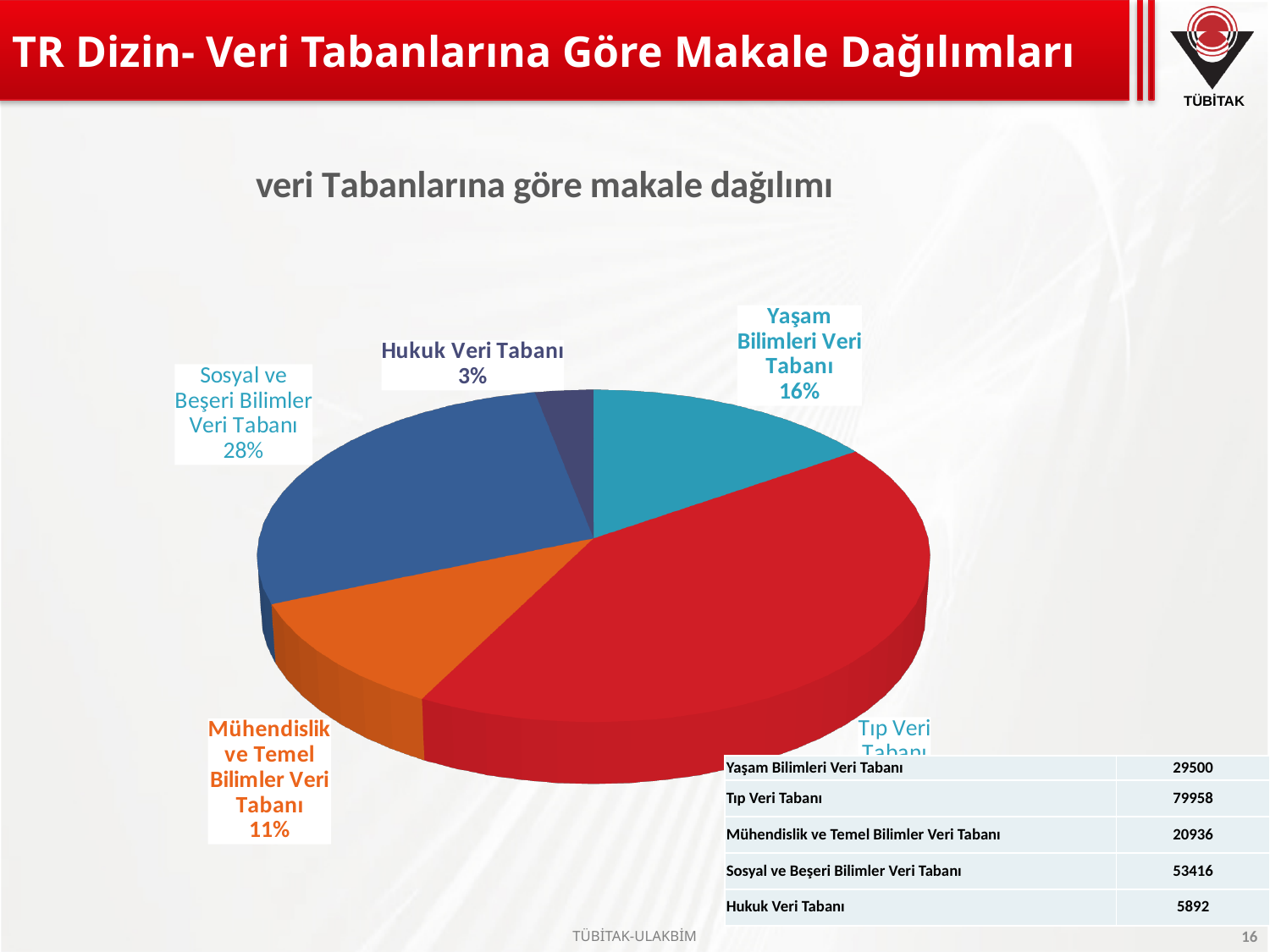
Which database has the largest slice of the pie? Tıp Veri Tabanı According to the table on the slide, how many articles are in Sosyal ve Beşeri Bilimler Veri Tabanı? 53416 According to the table on the slide, how many articles are in Tıp Veri Tabanı? 79958 What kind of chart is shown on the slide? Pie chart Which database has the smallest slice of the pie? Hukuk Veri Tabanı Which has a larger share of the pie, Yaşam Bilimleri Veri Tabanı or Mühendislik ve Temel Bilimler Veri Tabanı? Yaşam Bilimleri Veri Tabanı What is the title of the chart? veri Tabanlarına göre makale dağılımı How many slices does the pie chart have? 5 What share of the pie does Yaşam Bilimleri Veri Tabanı hold? 16% What share of the pie does Mühendislik ve Temel Bilimler Veri Tabanı hold? 11% What share of the pie does Hukuk Veri Tabanı hold? 3%